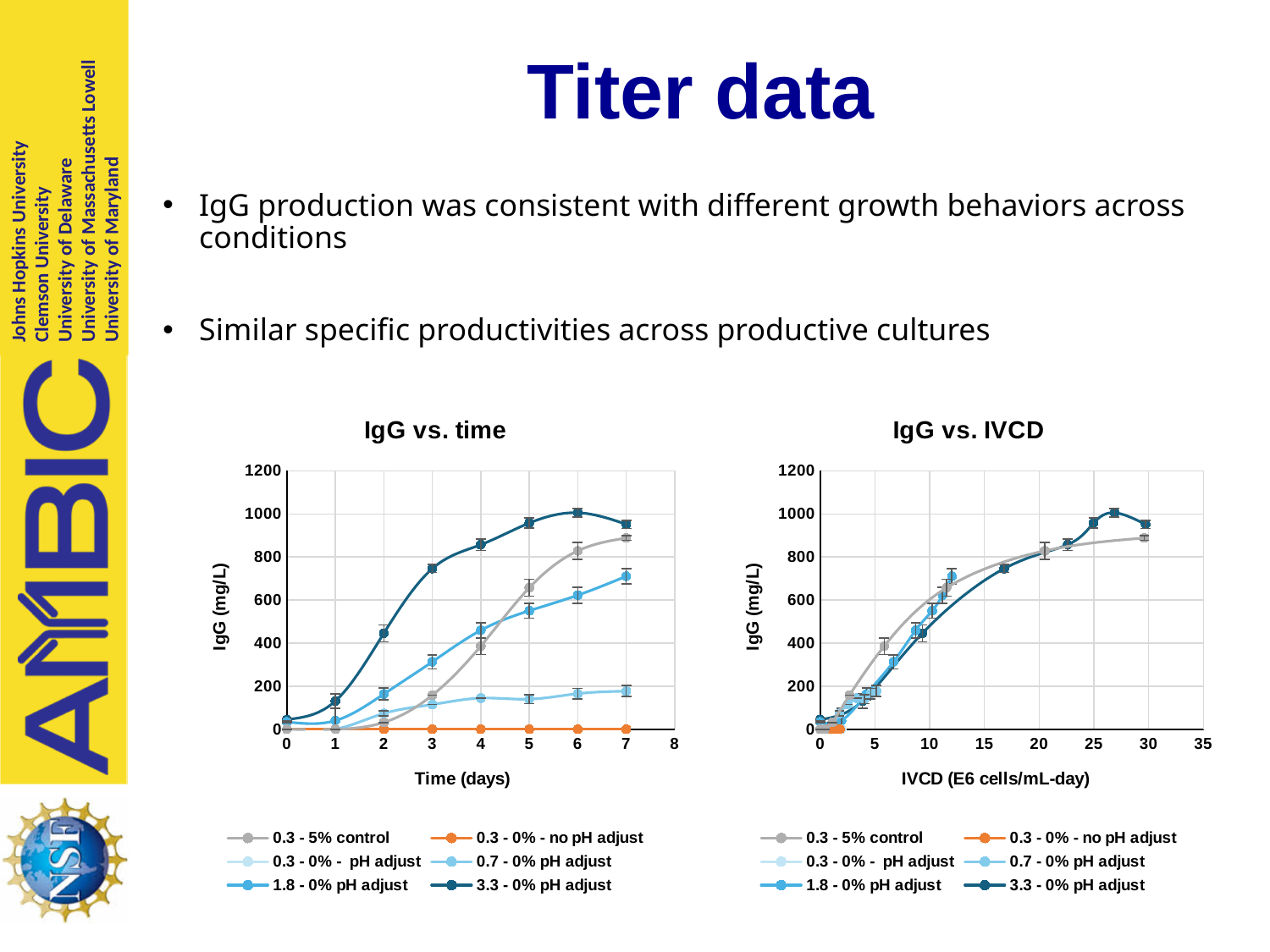
In the "IgG vs. time" chart, does the 3.3 - 0% pH adjust series rise or fall from day 0 to day 6? rise What kind of chart is the "IgG vs. time" chart? Line chart In the "IgG vs. IVCD" chart, is the value for 0.3 - 5% control at an IVCD of about 30 greater or less than 600? greater What is the x-axis label of the "IgG vs. IVCD" chart? IVCD (E6 cells/mL-day) How many series does the legend of the "IgG vs. time" chart list? 6 In the "IgG vs. time" chart, is the value for 3.3 - 0% pH adjust at day 6 greater or less than 800? greater In the "IgG vs. time" chart, at day 4, which series has the larger IgG value: 3.3 - 0% pH adjust or 0.3 - 5% control? 3.3 - 0% pH adjust What is the x-axis label of the "IgG vs. time" chart? Time (days) In the "IgG vs. time" chart, is the value for 0.3 - 5% control at day 7 greater or less than 800? greater In the "IgG vs. time" chart, which series reaches the highest IgG value? 3.3 - 0% pH adjust